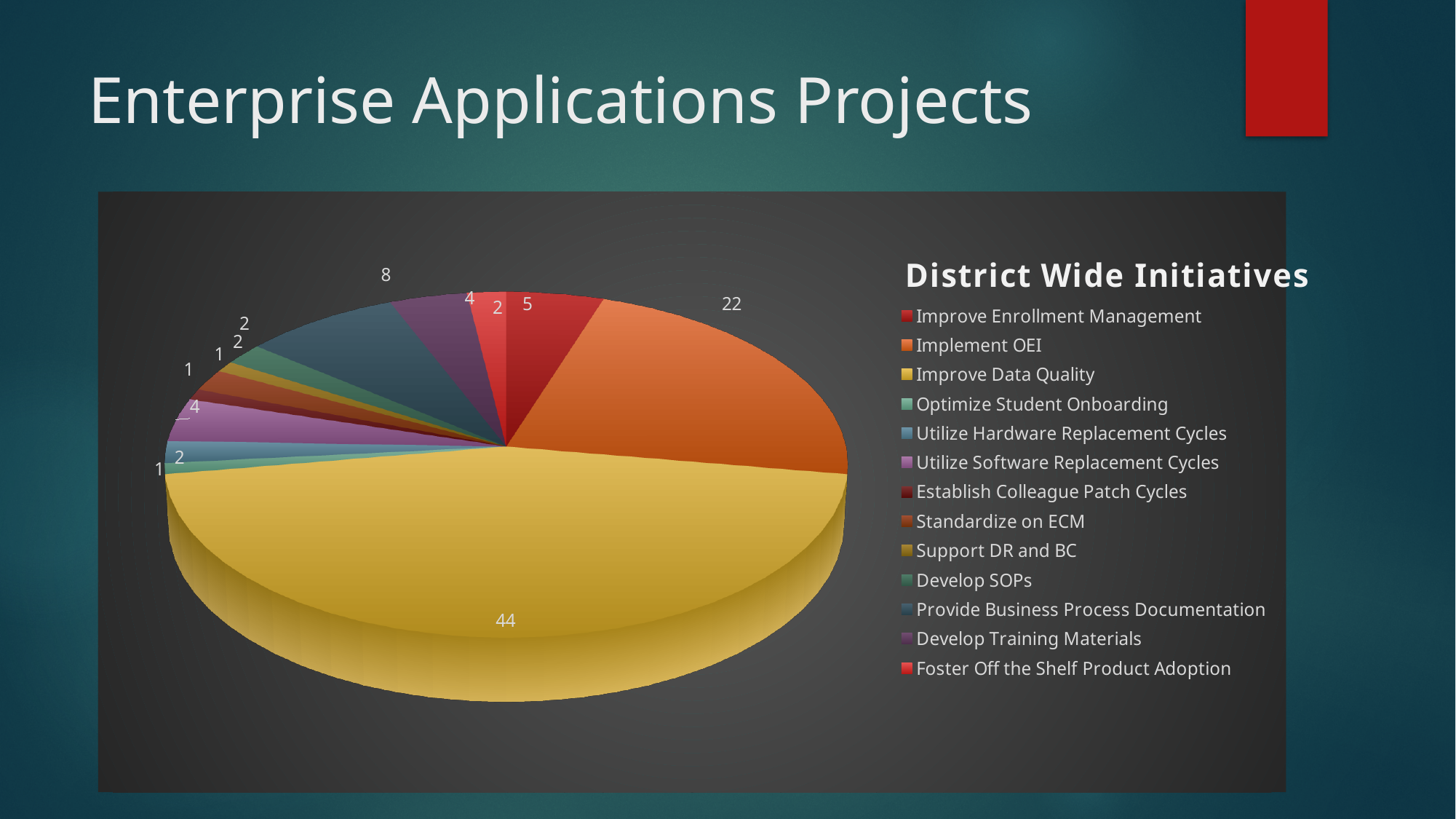
What type of chart is shown on the slide? Pie chart What is the value for Improve Data Quality? 44 What is the difference between the values for Improve Data Quality and Implement OEI? 22 How many initiatives are listed in the chart's legend? 13 Which is larger, the value for Implement OEI or the value for Provide Business Process Documentation? Implement OEI Which initiative has the largest slice of the pie? Improve Data Quality What is the value for Develop Training Materials? 4 What is the difference between the values for Provide Business Process Documentation and Improve Enrollment Management? 3 What is the value for Implement OEI? 22 What is the value for Improve Enrollment Management? 5 What is the value for Provide Business Process Documentation? 8 What is the title of the chart? District Wide Initiatives